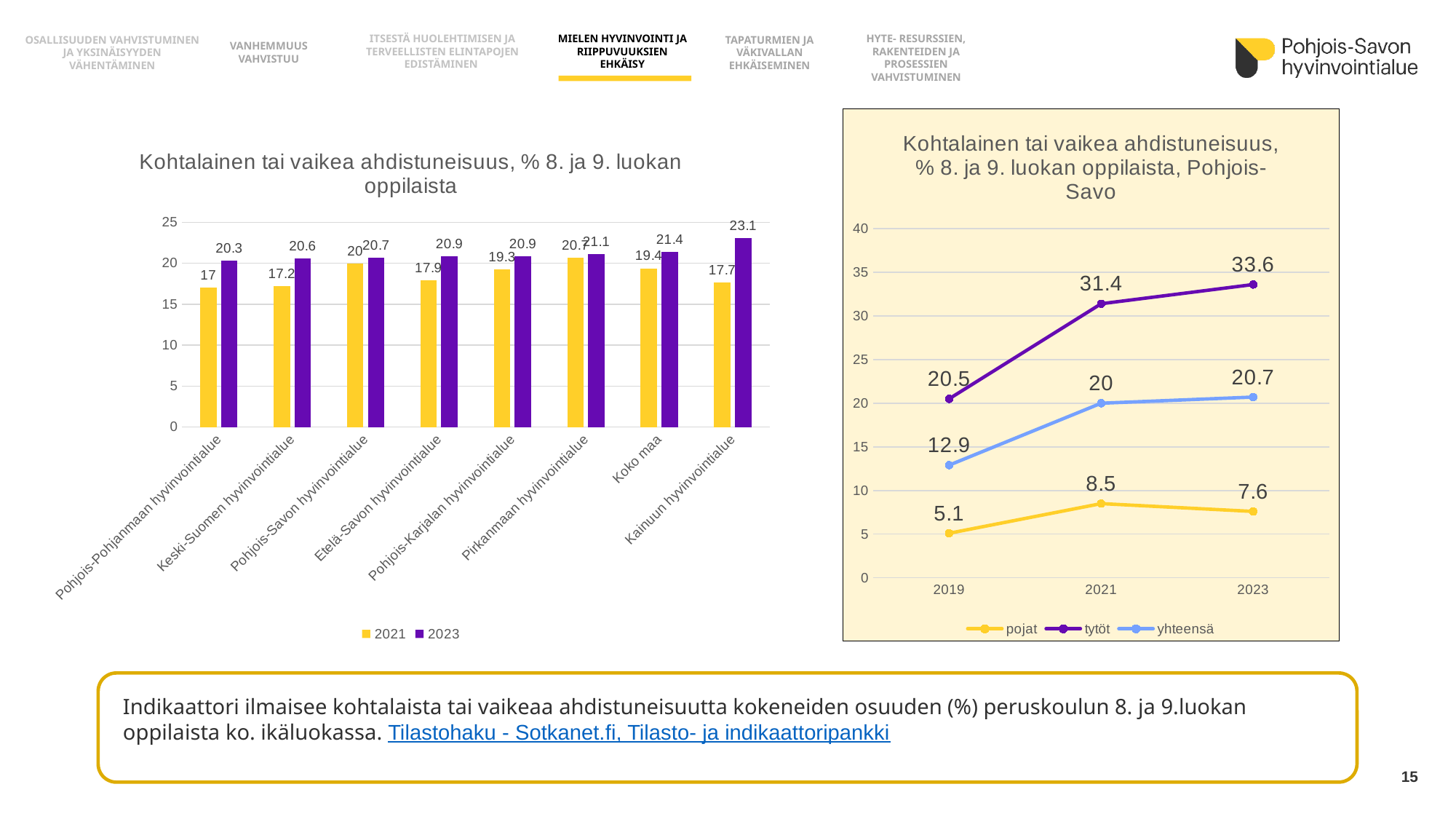
In the left bar chart, what is the difference between the 2023 and 2021 values for Kainuun hyvinvointialue? 5.4 In the left bar chart, what is the 2023 value for Kainuun hyvinvointialue? 23.1 In the left bar chart, which category has the highest 2023 value? Kainuun hyvinvointialue In the right line chart, what is the value for pojat in 2019? 5.1 In the right line chart titled 'Kohtalainen tai vaikea ahdistuneisuus, % 8. ja 9. luokan oppilaista, Pohjois-Savo', what is the value for tytöt in 2023? 33.6 In the right line chart, what is the difference between the yhteensä values for 2021 and 2019? 7.1 In the right line chart, how many series does the legend list? 3 In the left bar chart, how many categories are shown on the x axis? 8 In the right line chart, does the tytöt series rise or fall from 2019 to 2023? Rise What type of chart is the chart on the left? Bar chart In the left bar chart, which category has the lowest 2021 value? Pohjois-Pohjanmaan hyvinvointialue In the left bar chart, what is the 2021 value for Keski-Suomen hyvinvointialue? 17.2